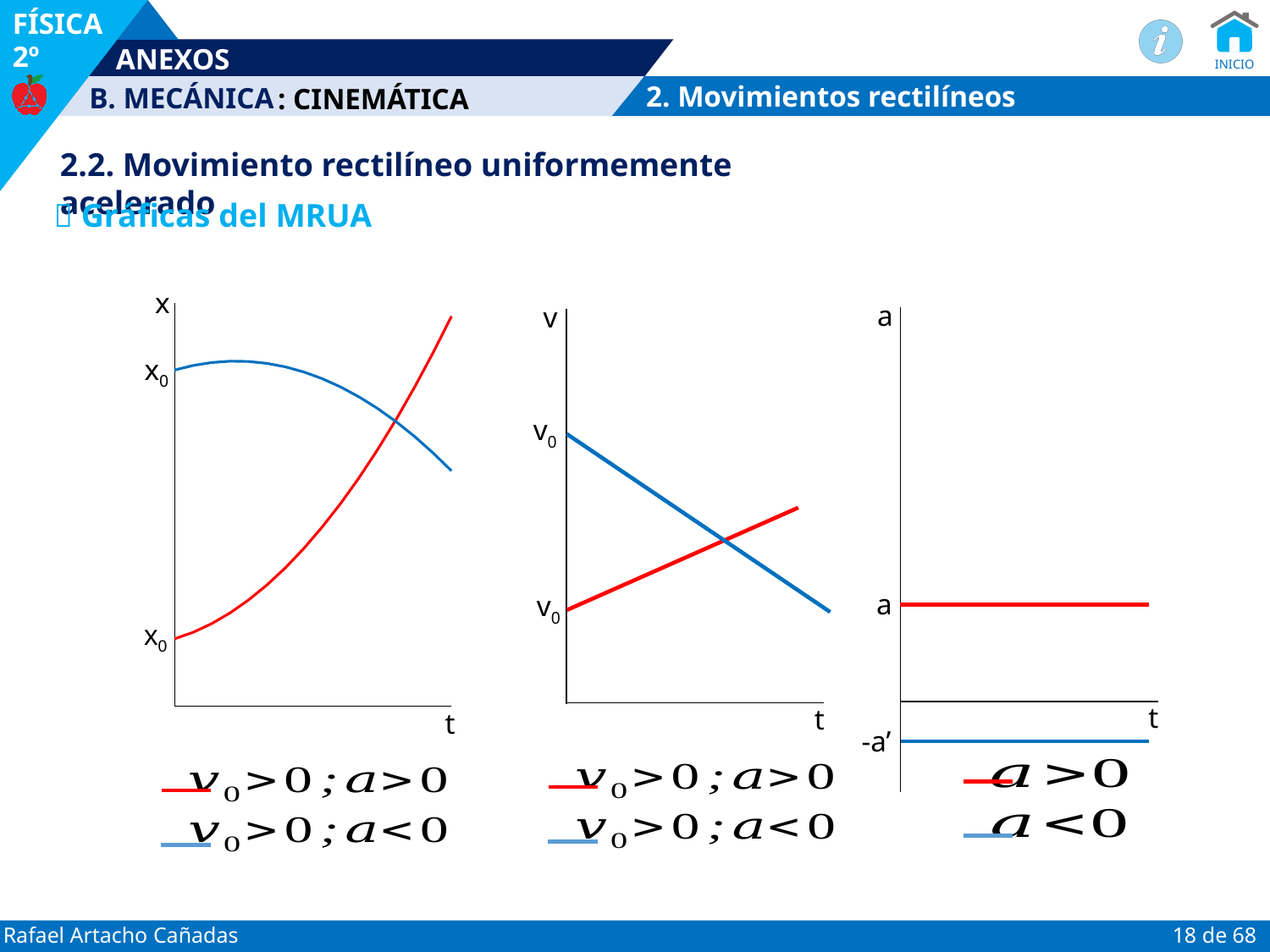
In the middle graph (v versus t), does the blue line rise or fall as t increases? falls In the right graph (a versus t), which line lies higher, the red line or the blue line? red line What kind of chart is the middle graph (v versus t)? line chart In the left graph (x versus t), does the red curve rise or fall as t increases? rises How many series does the legend list for each graph? 2 In the middle graph (v versus t), does the red line rise or fall as t increases? rises What is the label on the vertical axis of the middle graph? v In the right graph (a versus t), which colour represents a < 0? blue How many graphs are shown on the slide? 3